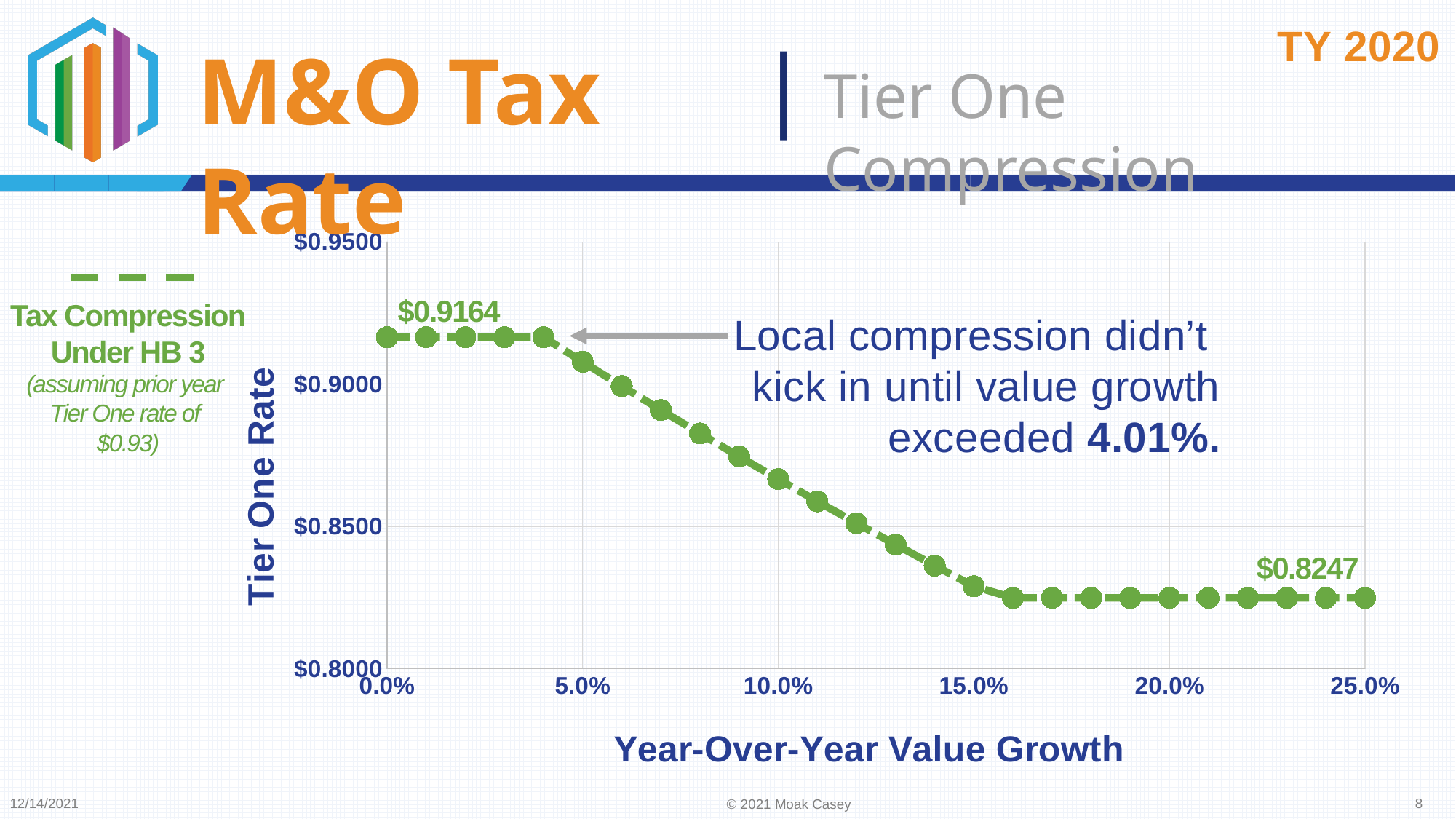
Which has the higher Tier One Rate: 0.0% value growth or 25.0% value growth? 0.0% Which has the higher Tier One Rate: 5.0% value growth or 15.0% value growth? 5.0% What is the Tier One Rate at 25.0% year-over-year value growth? $0.8247 Does the Tier One Rate rise or fall as year-over-year value growth increases? fall What is the Tier One Rate at 0.0% year-over-year value growth? $0.9164 What kind of chart is shown on the slide? line chart Is the Tier One Rate at 8.0% value growth greater or less than $0.9000? less How many data points are plotted on the line? 26 What is the title of the x axis of the chart? Year-Over-Year Value Growth Is the Tier One Rate at 20.0% value growth greater or less than $0.8500? less Is the Tier One Rate at 10.0% value growth greater or less than $0.8500? greater What is the difference between the Tier One Rate at 0.0% value growth and at 25.0% value growth? $0.0917